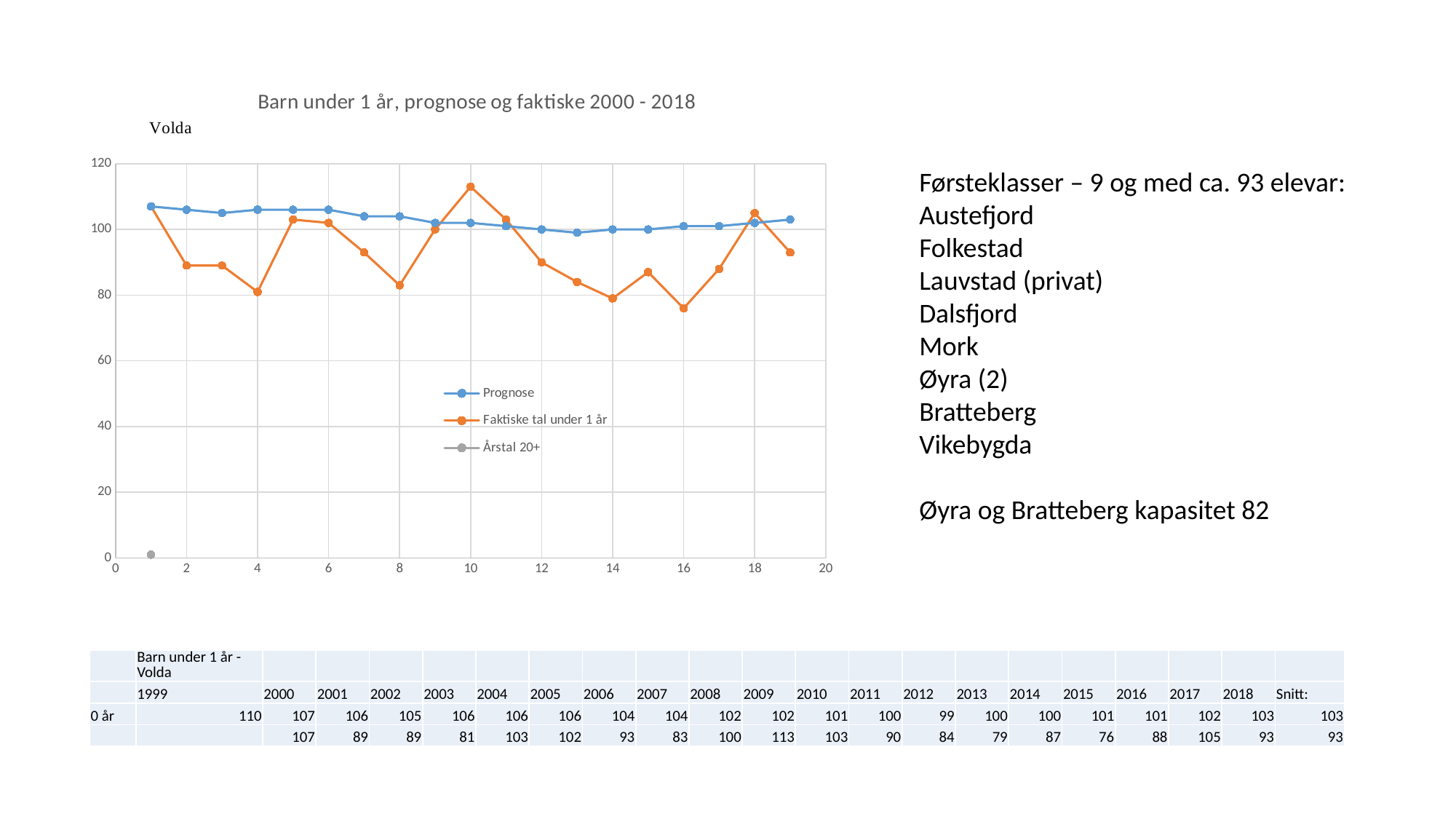
According to the table below the chart, what is the Faktiske tal under 1 år value for 2009? 113 What is the third entry in the chart legend? Årstal 20+ At x = 4, which series has the higher value, Prognose or Faktiske tal under 1 år? Prognose Is the Prognose value at x = 1 greater or less than 100? greater What kind of chart is shown on the slide? line chart At which x-axis value does the Faktiske tal under 1 år series reach its highest point? 10 What is the title of the chart? Barn under 1 år, prognose og faktiske 2000 - 2018 How many series does the chart legend list? 3 Is the Faktiske tal under 1 år value at x = 16 greater or less than 80? less At which x-axis value does the Faktiske tal under 1 år series reach its lowest point? 16 According to the table below the chart, what is the difference between the Faktiske value (113) and the Prognose value (102) for 2009? 11 How many data points does the Prognose series have? 19